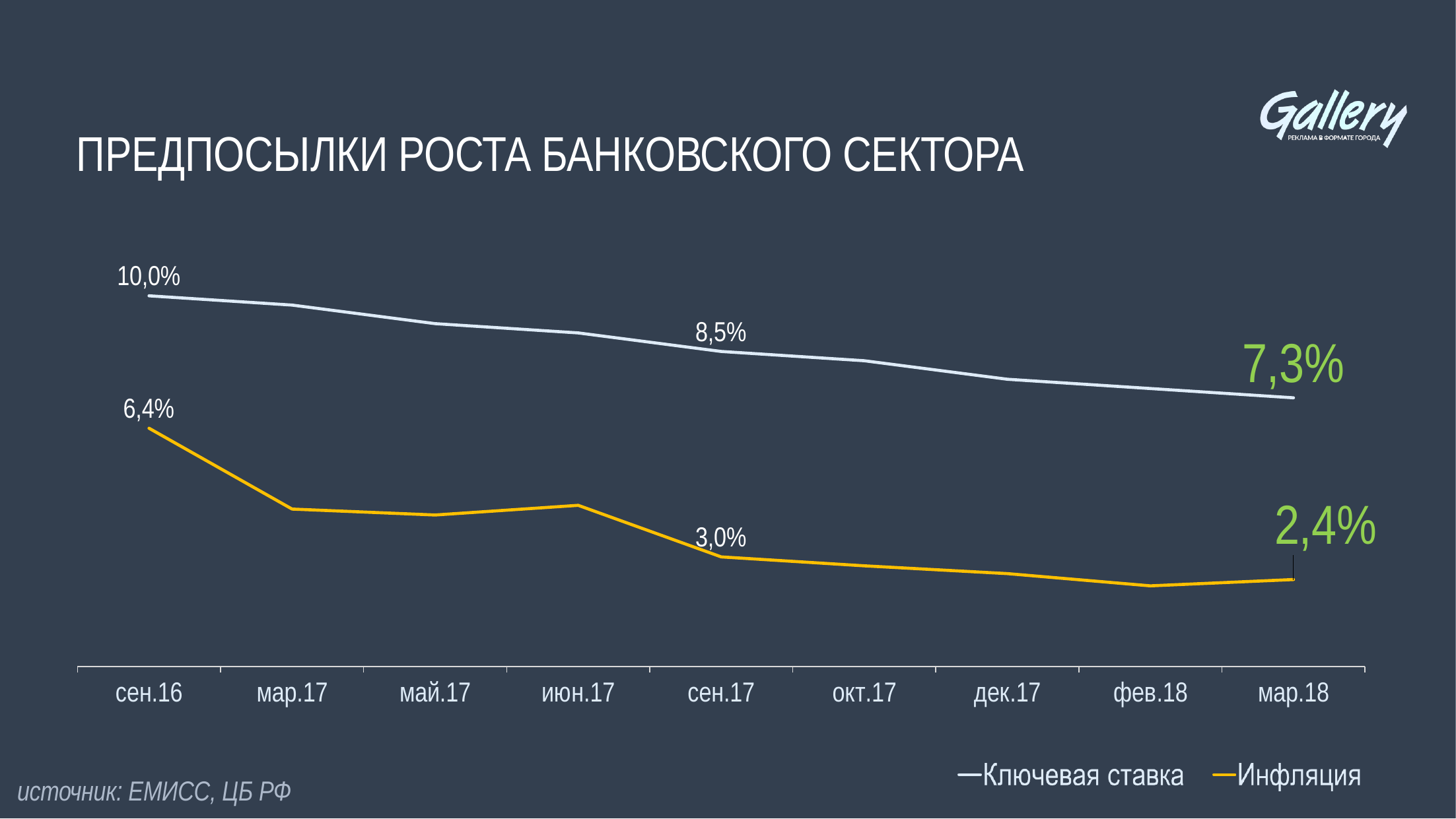
How many points are on the x axis of the chart? 9 Does Ключевая ставка rise or fall from сен.16 to мар.18? Fall How many series does the legend list? 2 What is the value of Ключевая ставка for мар.18? 7,3% What type of chart is shown on the slide? Line chart By how much did Инфляция fall from сен.16 to мар.18? 4,1% What is the value of Ключевая ставка for сен.16? 10,0% What is the value of Ключевая ставка for сен.17? 8,5% What is the value of Инфляция for сен.16? 6,4% What is the difference between Ключевая ставка and Инфляция in сен.17? 5,5% Which series is higher in мар.18, Ключевая ставка or Инфляция? Ключевая ставка What is the value of Инфляция for мар.18? 2,4%